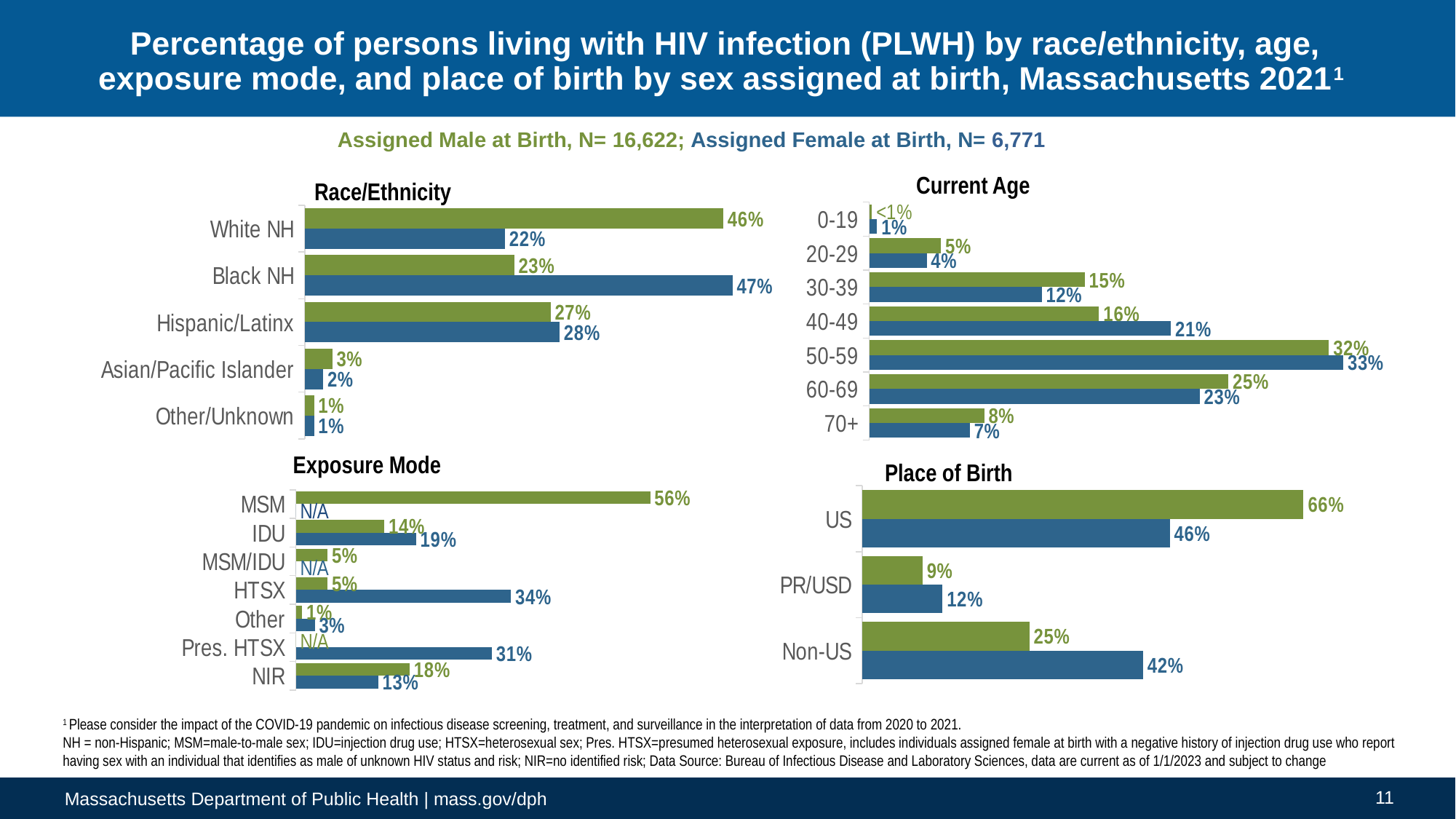
In the Race/Ethnicity chart, which category has the lowest value for persons assigned female at birth? Other/Unknown In the Race/Ethnicity chart, what percentage of persons assigned female at birth are Black NH? 47% In the Current Age chart, what is the value for the 50-59 age group among persons assigned female at birth? 33% In the Exposure Mode chart, what is the value for MSM among persons assigned male at birth? 56% In the Place of Birth chart, what is the difference between the US values for persons assigned male at birth and persons assigned female at birth? 20% In the Race/Ethnicity chart, what percentage of persons assigned male at birth are White NH? 46% In the Exposure Mode chart, which is larger for persons assigned female at birth: HTSX or Pres. HTSX? HTSX How many age groups are shown in the Current Age chart? 7 In the Current Age chart, what is the difference between the assigned female at birth and assigned male at birth values for the 40-49 age group? 5% In the Place of Birth chart, what is the value for Non-US among persons assigned female at birth? 42% What type of chart is the Place of Birth chart? Bar chart In the Current Age chart, which age group has the highest value for persons assigned male at birth? 50-59